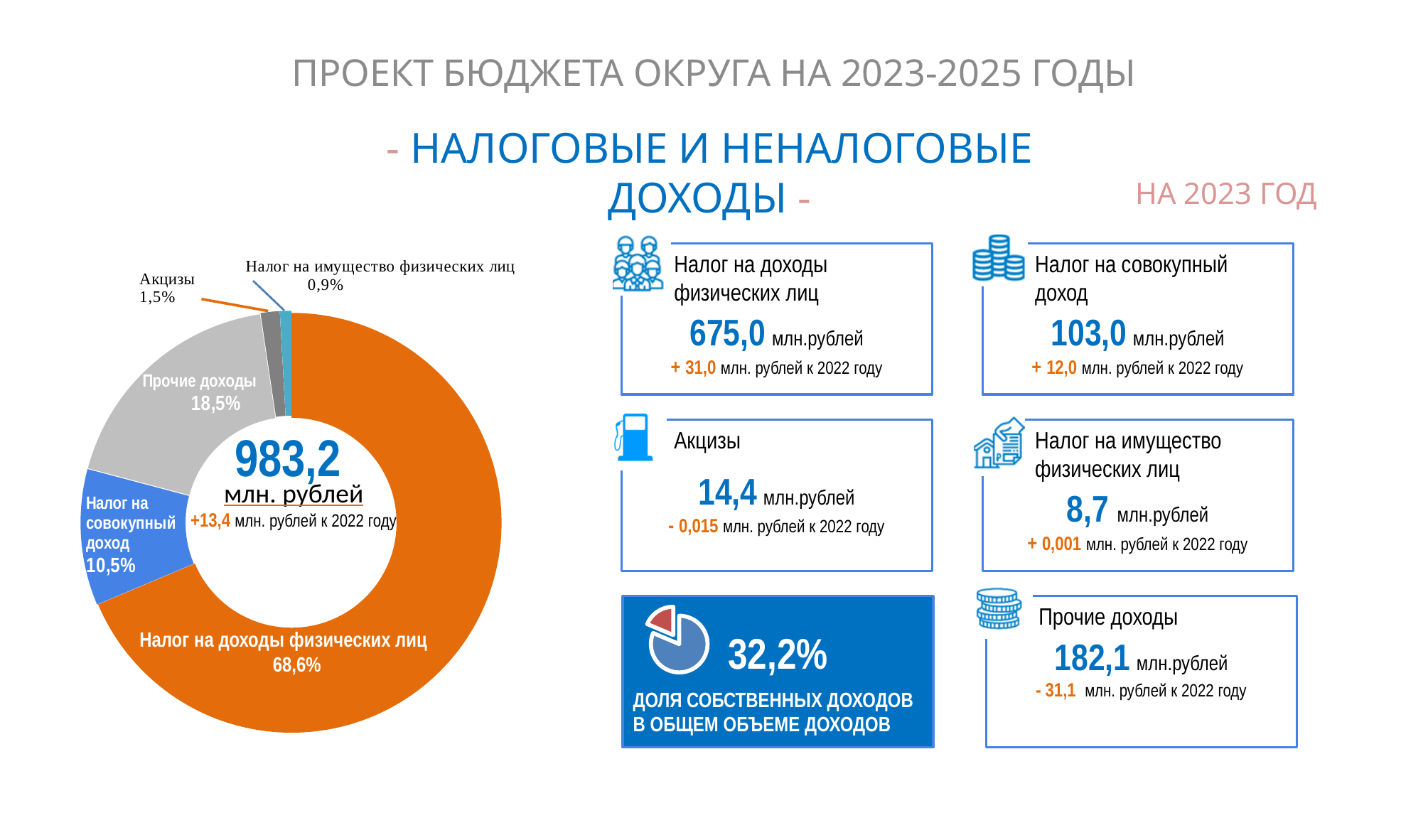
Which slice of the pie chart is the largest? Налог на доходы физических лиц What share of the pie chart is labelled for Налог на имущество физических лиц? 0,9% What kind of chart is shown on the left of the slide? Pie chart (donut) What is the difference in percentage points between the Прочие доходы slice and the Налог на совокупный доход slice in the pie chart? 8,0 What share of the pie chart is labelled for Прочие доходы? 18,5% How many slices does the pie chart have? 5 What share of the pie chart is labelled for Налог на доходы физических лиц? 68,6% Which slice of the pie chart is the smallest? Налог на имущество физических лиц In the pie chart, which is larger: Прочие доходы or Налог на совокупный доход? Прочие доходы What total value is printed in the centre of the pie chart? 983,2 млн. рублей